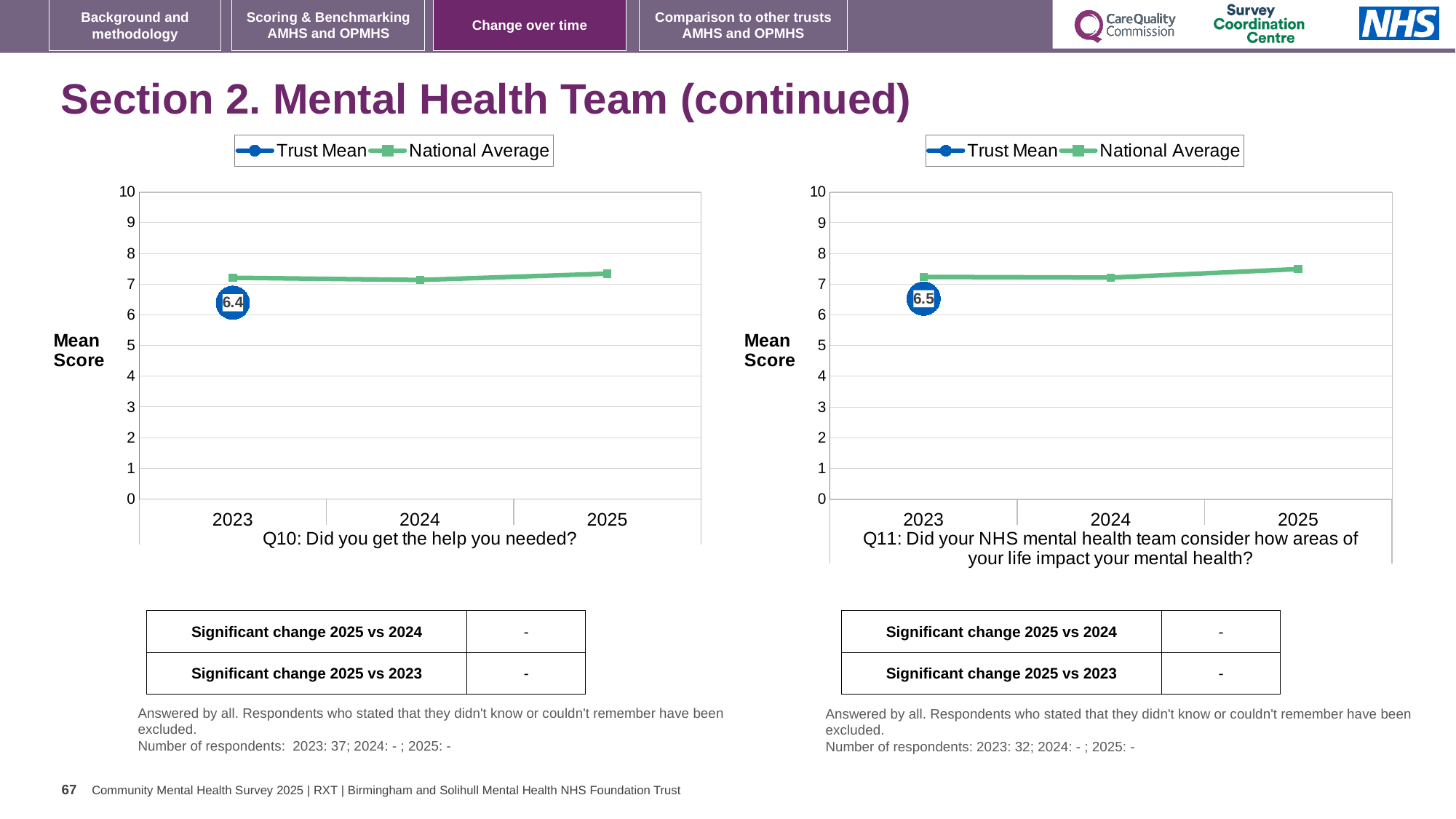
How many years are shown on the x axis of the Q10 chart on the left? 3 What are the two series named in the legend of the Q10 chart on the left? Trust Mean and National Average What is the y-axis label of the Q11 chart on the right? Mean Score In the Q11 chart on the right, which is higher for 2023: the Trust Mean or the National Average? National Average How many series does the legend of the Q11 chart on the right list? 2 In the Q11 chart on the right, what is the Trust Mean score for 2023? 6.5 In the Q10 chart on the left, is the National Average for 2025 greater or less than 7? greater In the Q10 chart on the left, is the Trust Mean for 2023 greater or less than 7? less In the Q10 chart on the left, what is the Trust Mean score for 2023? 6.4 What kind of chart is the Q10 chart on the left? Line chart In the Q11 chart on the right, is the National Average for 2025 greater or less than 8? less In the Q11 chart on the right, does the National Average rise or fall from 2024 to 2025? Rise